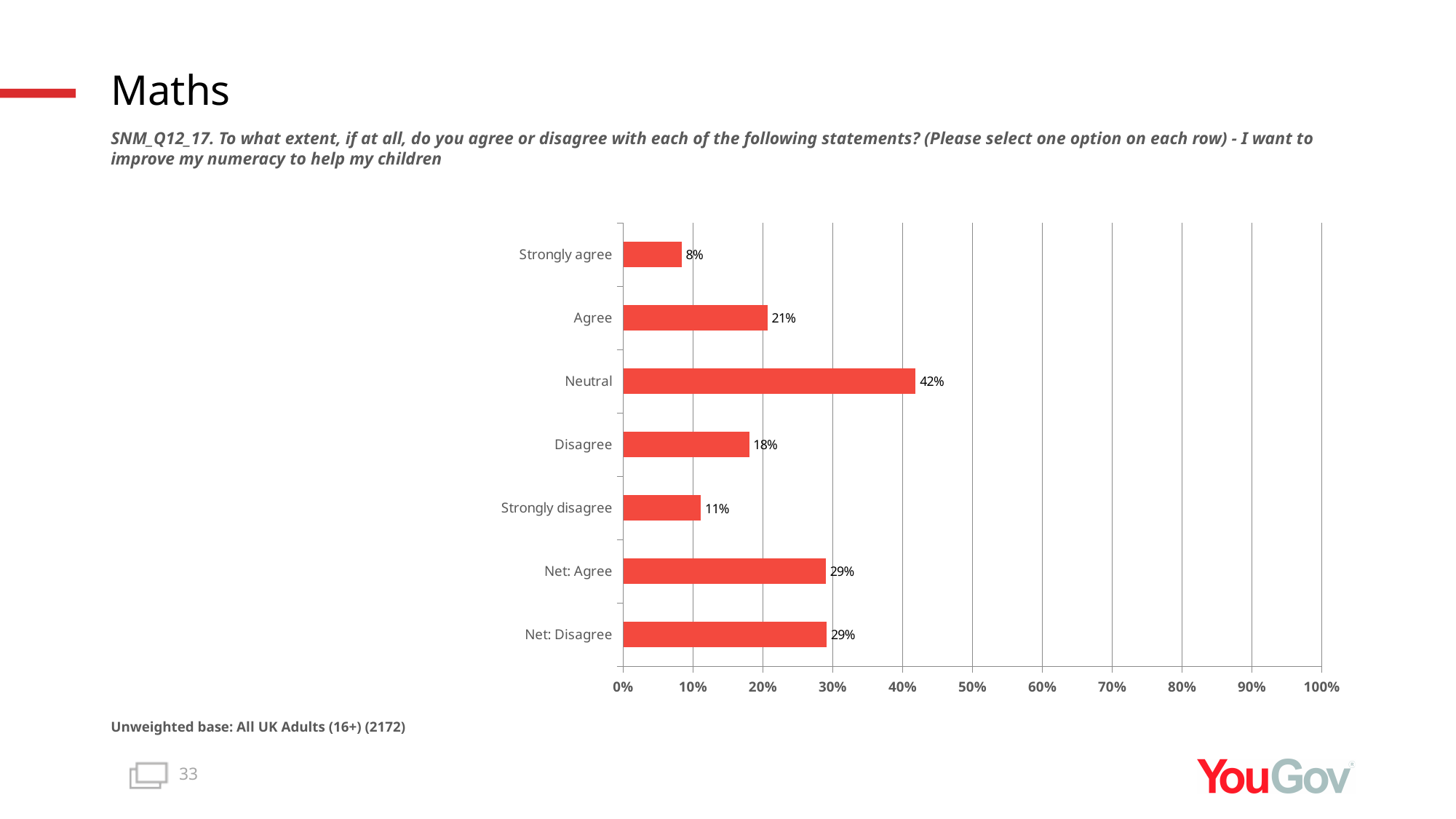
What is the value for 'Strongly agree'? 8% Which is larger, 'Agree' or 'Strongly disagree'? Agree What is the value for 'Strongly disagree'? 11% What is the unweighted base stated below the chart? All UK Adults (16+) (2172) Is the value for 'Neutral' greater or less than 40%? greater What is the difference between the 'Agree' and 'Disagree' values? 3% How many categories are shown on the chart? 7 What percentage of respondents selected 'Neutral'? 42% What is the value for 'Net: Agree'? 29% Which category has the highest value? Neutral Which category has the lowest value? Strongly agree What kind of chart is shown on the slide? Bar chart